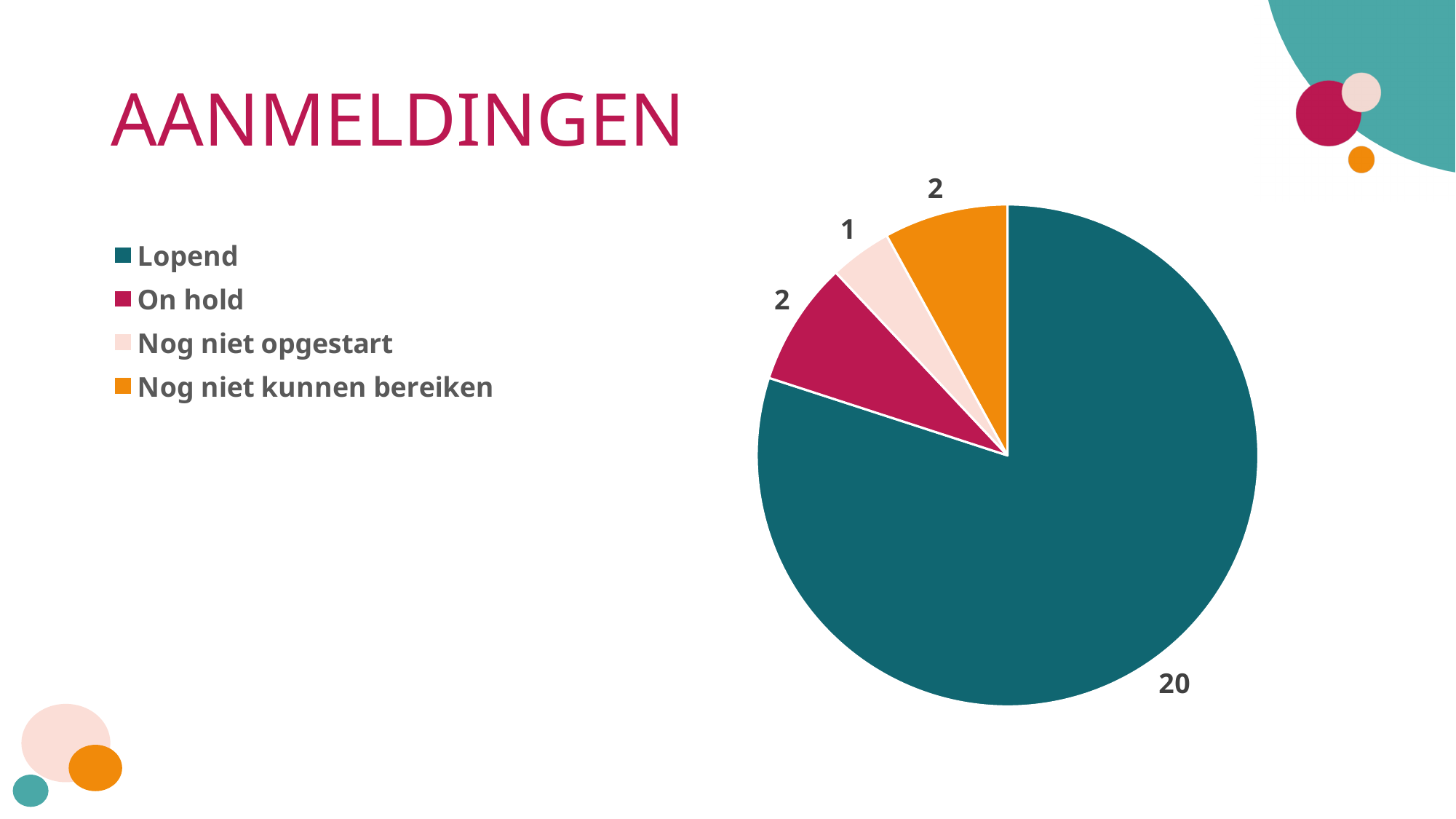
Which is larger, the value for On hold or the value for Nog niet opgestart? On hold What share of the pie does Lopend represent? 80% What is the value for Lopend? 20 What is the value for Nog niet opgestart? 1 What colour is the slice for Nog niet kunnen bereiken? orange What is the difference between the values for Lopend and On hold? 18 What kind of chart is shown on the slide? pie chart Which category has the smallest slice? Nog niet opgestart What is the value for Nog niet kunnen bereiken? 2 How many categories does the pie chart have? 4 Which category has the largest slice? Lopend What is the value for On hold? 2